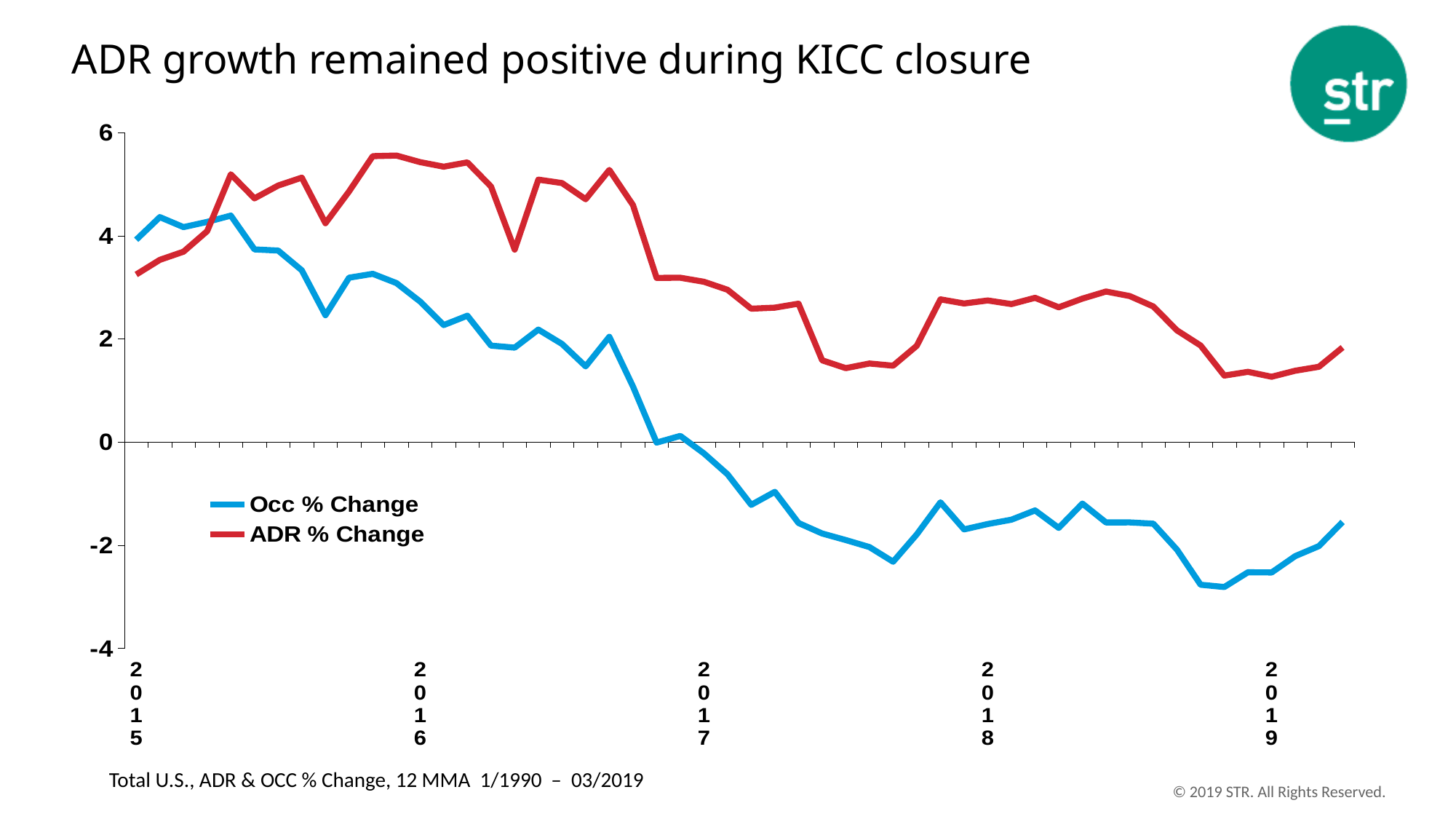
At the 2017 tick, which series has the higher value, Occ % Change or ADR % Change? ADR % Change Is the value of Occ % Change at the 2015 tick greater or less than 2? greater Is the value of Occ % Change at the 2018 tick greater or less than 0? less Is the value of ADR % Change at the 2016 tick greater or less than 4? greater Does the ADR % Change line rise or fall overall from 2015 to 2019? fall What are the two series named in the legend? Occ % Change and ADR % Change How many series does the legend list? 2 What kind of chart is shown on the slide? line chart Does the Occ % Change line rise or fall overall from 2015 to 2019? fall At the 2016 tick, which series has the higher value, Occ % Change or ADR % Change? ADR % Change What is the title of the chart on the slide? ADR growth remained positive during KICC closure